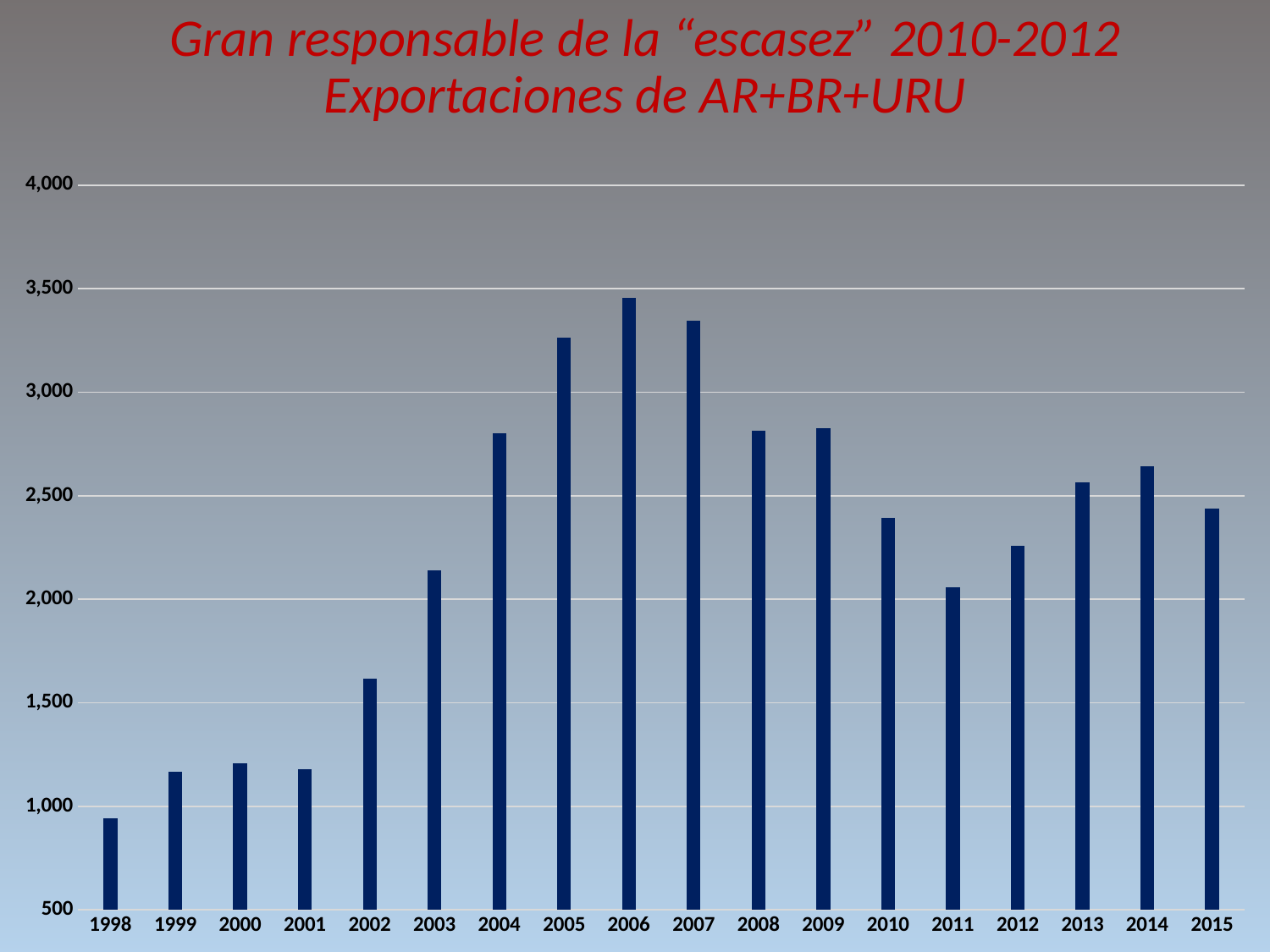
What is the second line of the chart title? Exportaciones de AR+BR+URU Which year has the lowest value? 1998 How many years are plotted on the x axis? 18 Which year has the larger value, 2004 or 2010? 2004 What kind of chart is shown on the slide? bar chart Is the value for 2006 greater or less than 3,000? greater Is the value for 1998 greater or less than 1,000? less Which year has the highest value? 2006 Is the value for 2010 greater or less than 2,500? less Do the values generally rise or fall from 1998 to 2006? rise